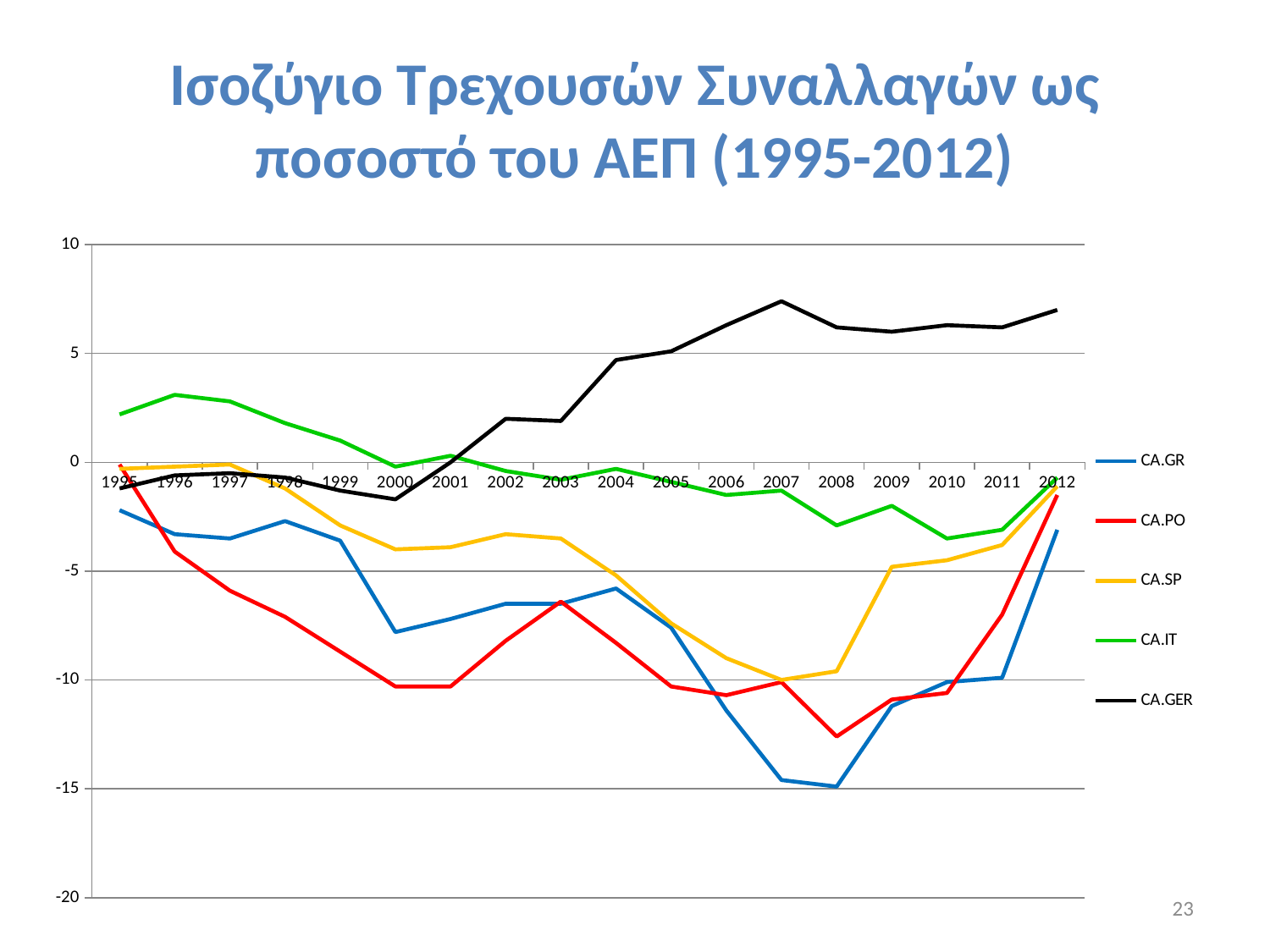
Is the value for CA.SP in 2007 greater or less than -5? less Is the value for CA.IT in 1996 greater or less than 0? greater Is the value for CA.GR in 2008 greater or less than -10? less Which series has the highest value in 2012? CA.GER Which series has the lowest value in 2008? CA.GR Does the CA.GER line rise or fall from 2001 to 2007? rise How many years are shown along the x axis? 18 What kind of chart is shown on the slide? line chart In 2008, which series has the higher value, CA.GER or CA.GR? CA.GER How many series does the legend list? 5 What colour is the CA.GER line? black